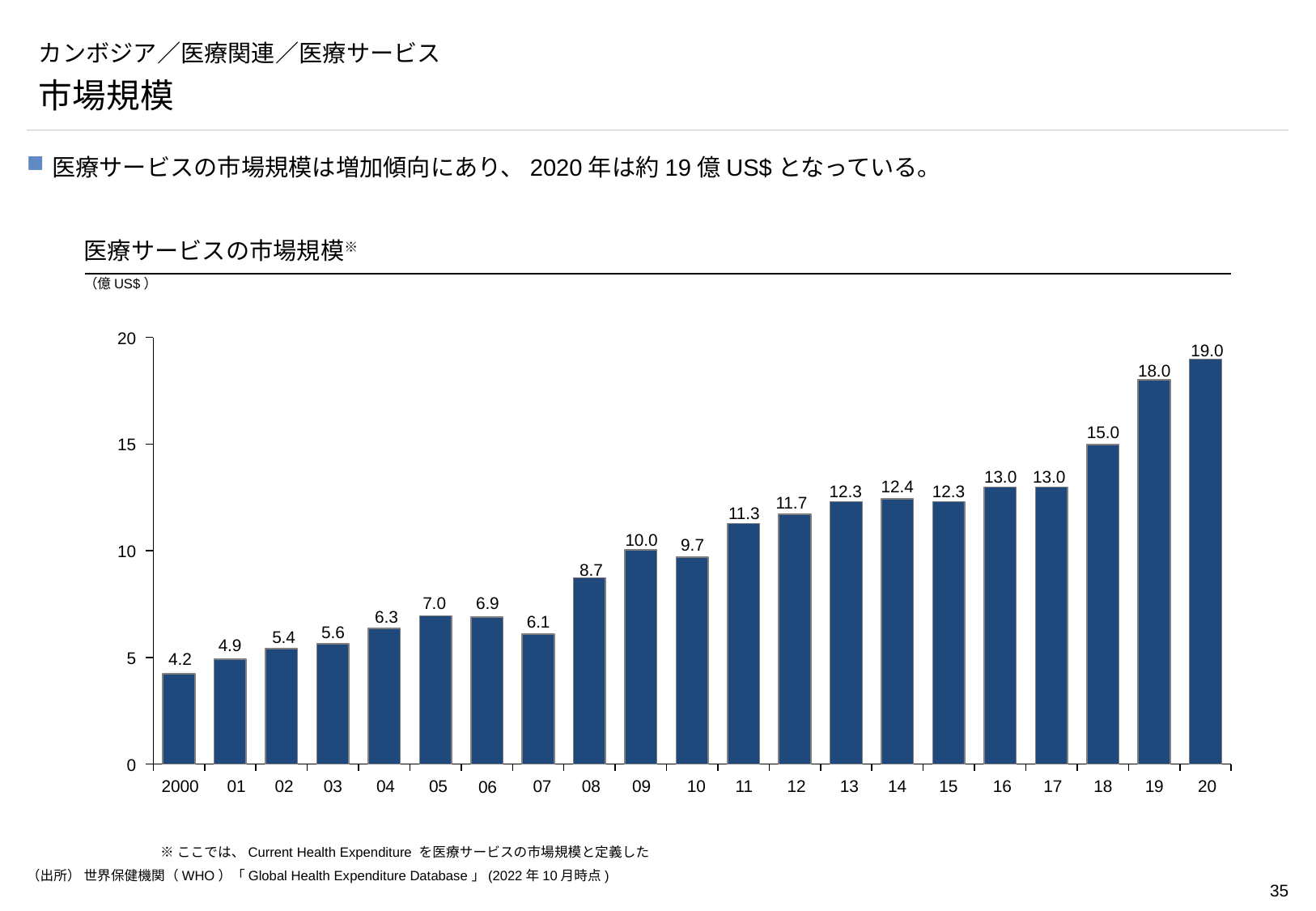
What is the value shown for 2008 (labelled 08)? 8.7 How many years (bars) are plotted in the chart? 21 What is the value shown for 2020 (labelled 20)? 19.0 What kind of chart is shown? bar chart What unit is shown for the y axis of the chart? 億US$ What is the difference between the values for 20 and 19? 1.0 Which year has the highest value? 20 Which is larger, the value for 06 or the value for 07? 06 Is the value for 18 greater or less than 10? greater Do the values generally rise or fall from 2000 to 20? rise What is the market size value shown for 2000? 4.2 Which year has the lowest value? 2000